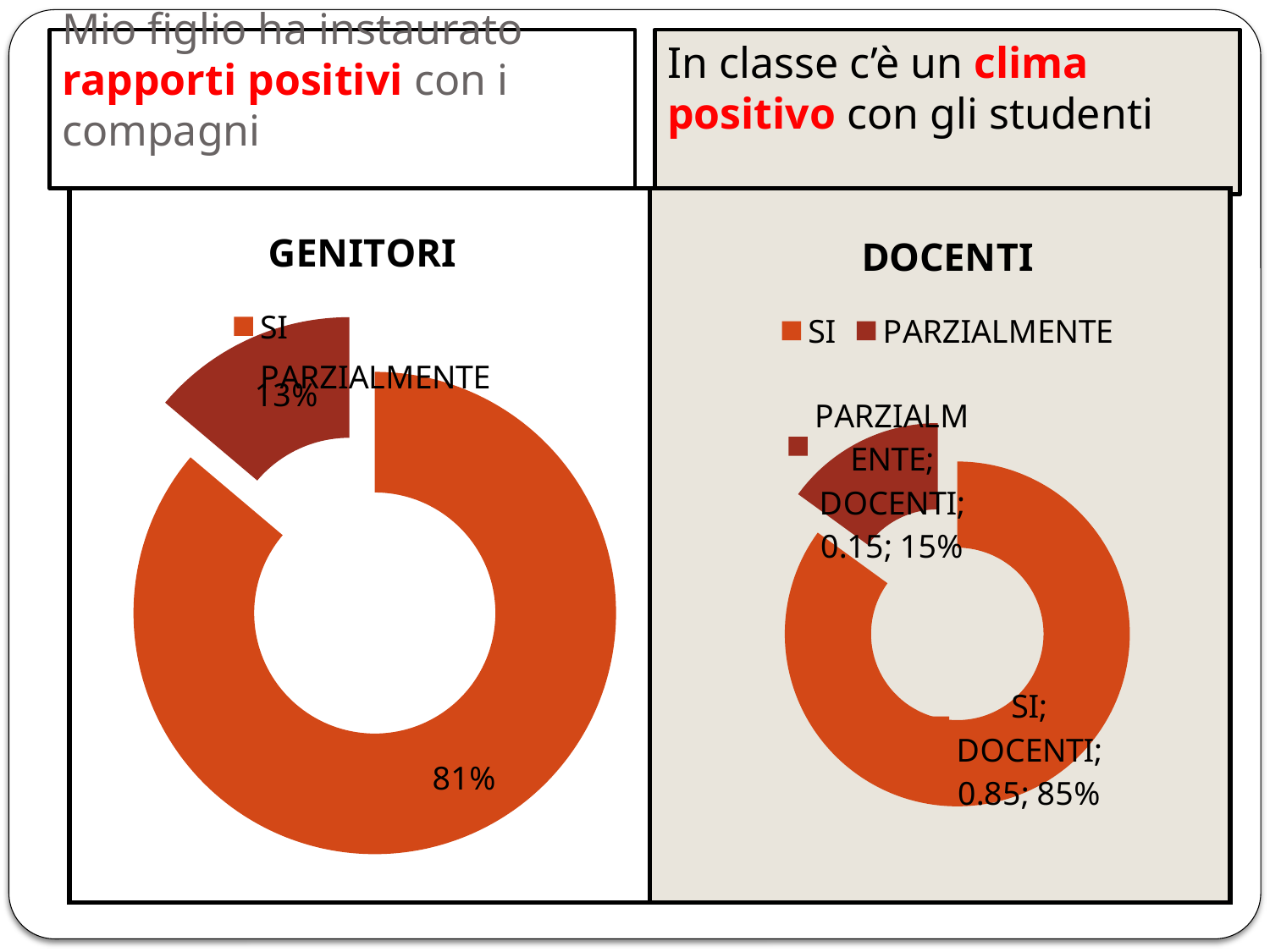
How many entries does the legend of the DOCENTI chart list? 2 In the DOCENTI chart, what percentage is shown for SI? 85% In the DOCENTI chart, what is the difference between the SI and PARZIALMENTE percentages? 70% In the GENITORI chart, which category has the smallest share? PARZIALMENTE What is the title of the chart on the right side of the slide? DOCENTI In the GENITORI chart, what percentage is shown for SI? 81% In the GENITORI chart, what is the difference between the SI and PARZIALMENTE percentages? 68% Which is larger: the SI share in the GENITORI chart or the SI share in the DOCENTI chart? DOCENTI In the DOCENTI chart, what percentage is shown for PARZIALMENTE? 15% What kind of chart is the GENITORI chart? Doughnut (pie) chart In the GENITORI chart, what percentage is shown for PARZIALMENTE? 13% In the DOCENTI chart, which category has the largest share? SI